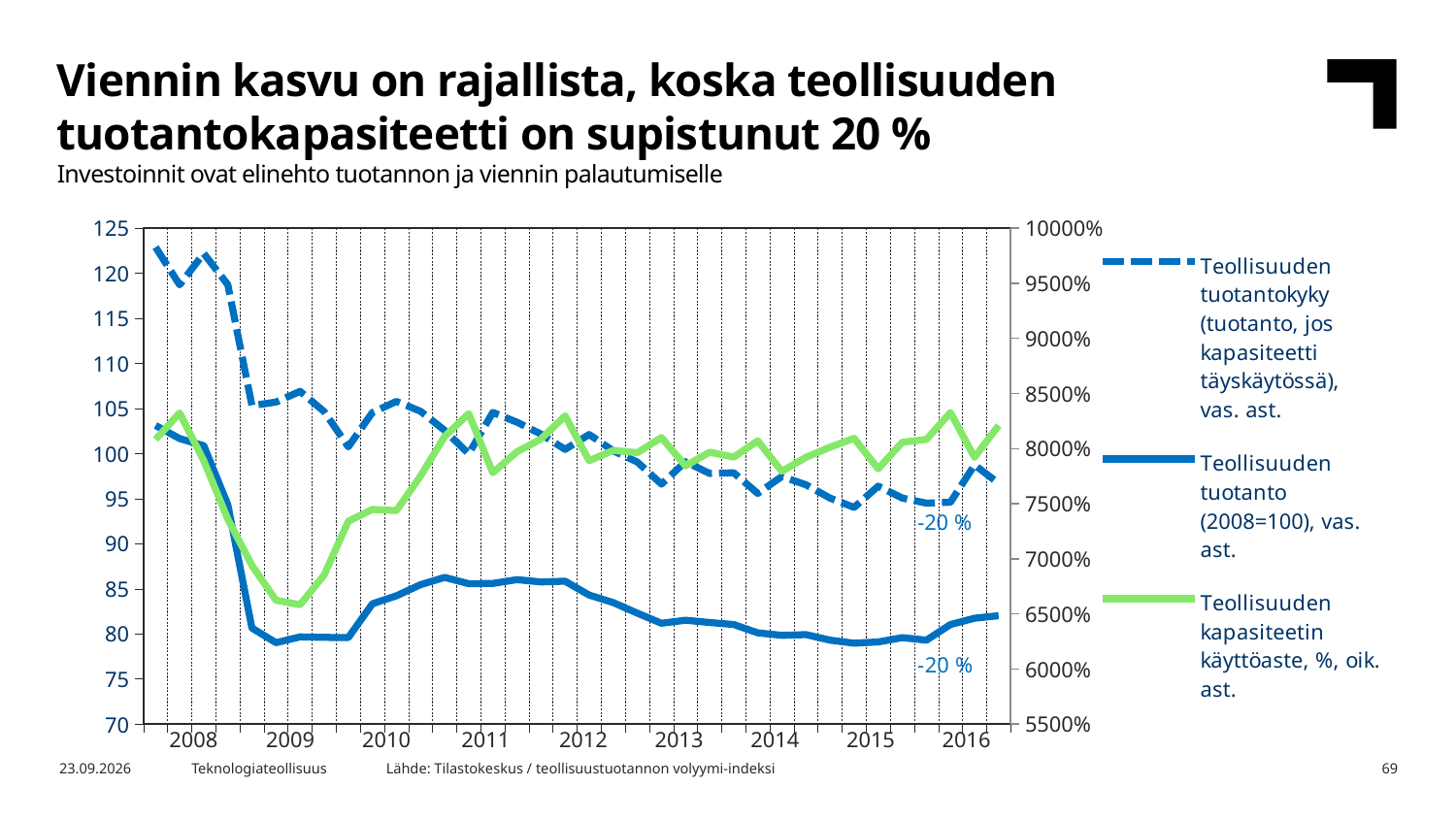
Is the value of Teollisuuden tuotanto (2008=100) at the end of 2016 greater or less than 90? less How many series does the legend list? 3 Which series is drawn with a dashed line? Teollisuuden tuotantokyky (tuotanto, jos kapasiteetti täyskäytössä), vas. ast. Which series is plotted on the right-hand axis (oik. ast.)? Teollisuuden kapasiteetin käyttöaste, %, oik. ast. At the end of 2016, which is higher on the left axis: Teollisuuden tuotantokyky or Teollisuuden tuotanto (2008=100)? Teollisuuden tuotantokyky What is the highest value shown on the left-hand axis? 125 Does the Teollisuuden tuotanto (2008=100) series rise or fall from 2008 to 2016? fall Is the value of Teollisuuden tuotantokyky at the start of 2008 greater or less than 115? greater Does the Teollisuuden tuotantokyky series rise or fall from 2008 to 2016? fall How many year labels are shown on the x axis? 9 What kind of chart is shown on the slide? line chart Is the value of Teollisuuden tuotanto (2008=100) at the start of 2009 greater or less than 85? less